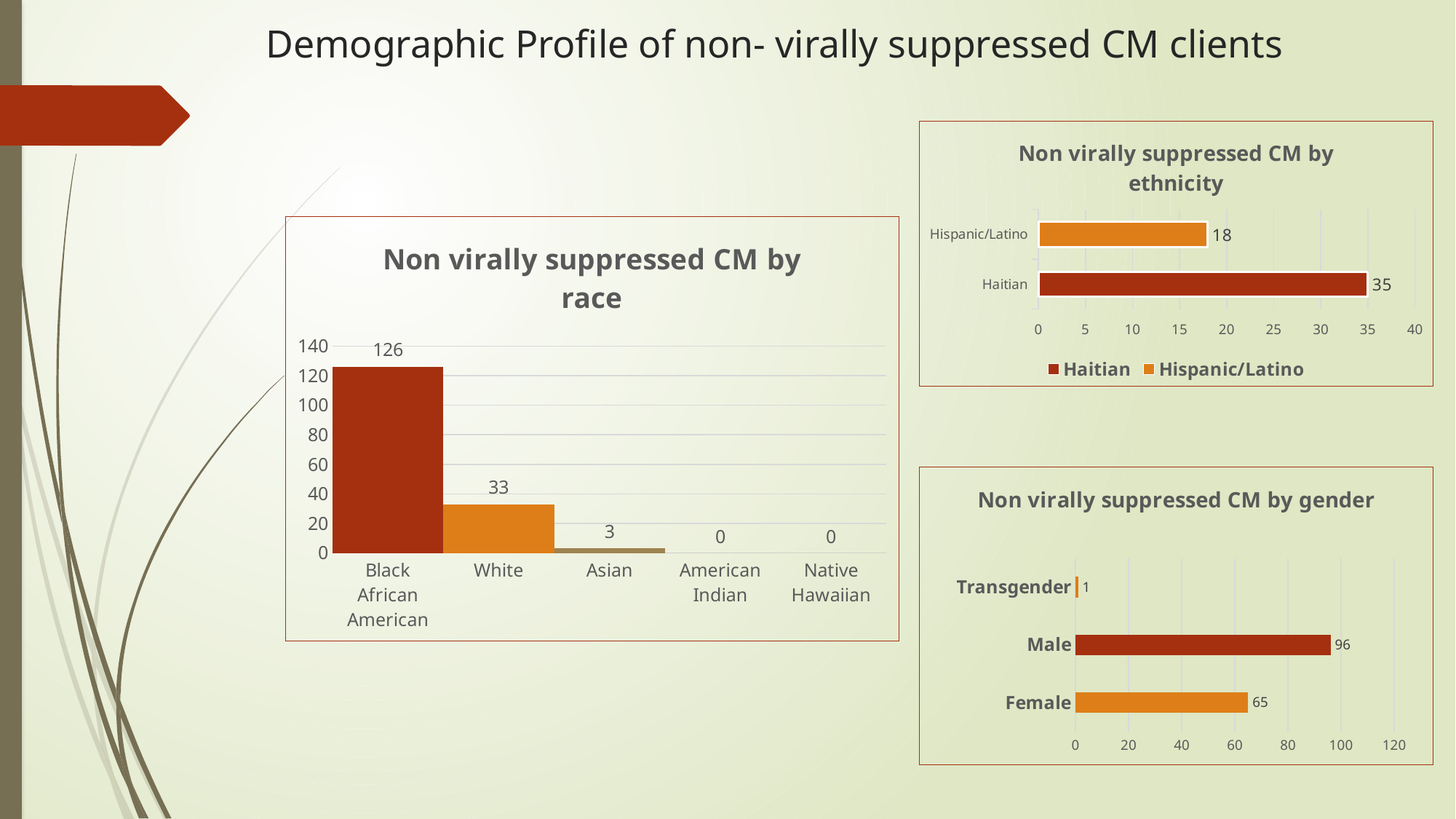
What kind of chart is the 'Non virally suppressed CM by gender' chart? Bar chart In the 'Non virally suppressed CM by race' chart, which race category has the highest value? Black African American In the 'Non virally suppressed CM by race' chart, what is the difference between the values for Black African American and White? 93 In the 'Non virally suppressed CM by race' chart, what is the value for White? 33 In the 'Non virally suppressed CM by gender' chart, what is the value for Male? 96 In the 'Non virally suppressed CM by race' chart, what is the value for Black African American? 126 In the 'Non virally suppressed CM by ethnicity' chart, what is the value for Haitian? 35 In the 'Non virally suppressed CM by race' chart, how many race categories are shown on the x axis? 5 In the 'Non virally suppressed CM by ethnicity' chart, what is the difference between the Haitian and Hispanic/Latino values? 17 In the 'Non virally suppressed CM by gender' chart, which gender category has the lowest value? Transgender In the 'Non virally suppressed CM by ethnicity' chart, how many entries does the legend list? 2 In the 'Non virally suppressed CM by gender' chart, which is larger, the value for Male or the value for Female? Male